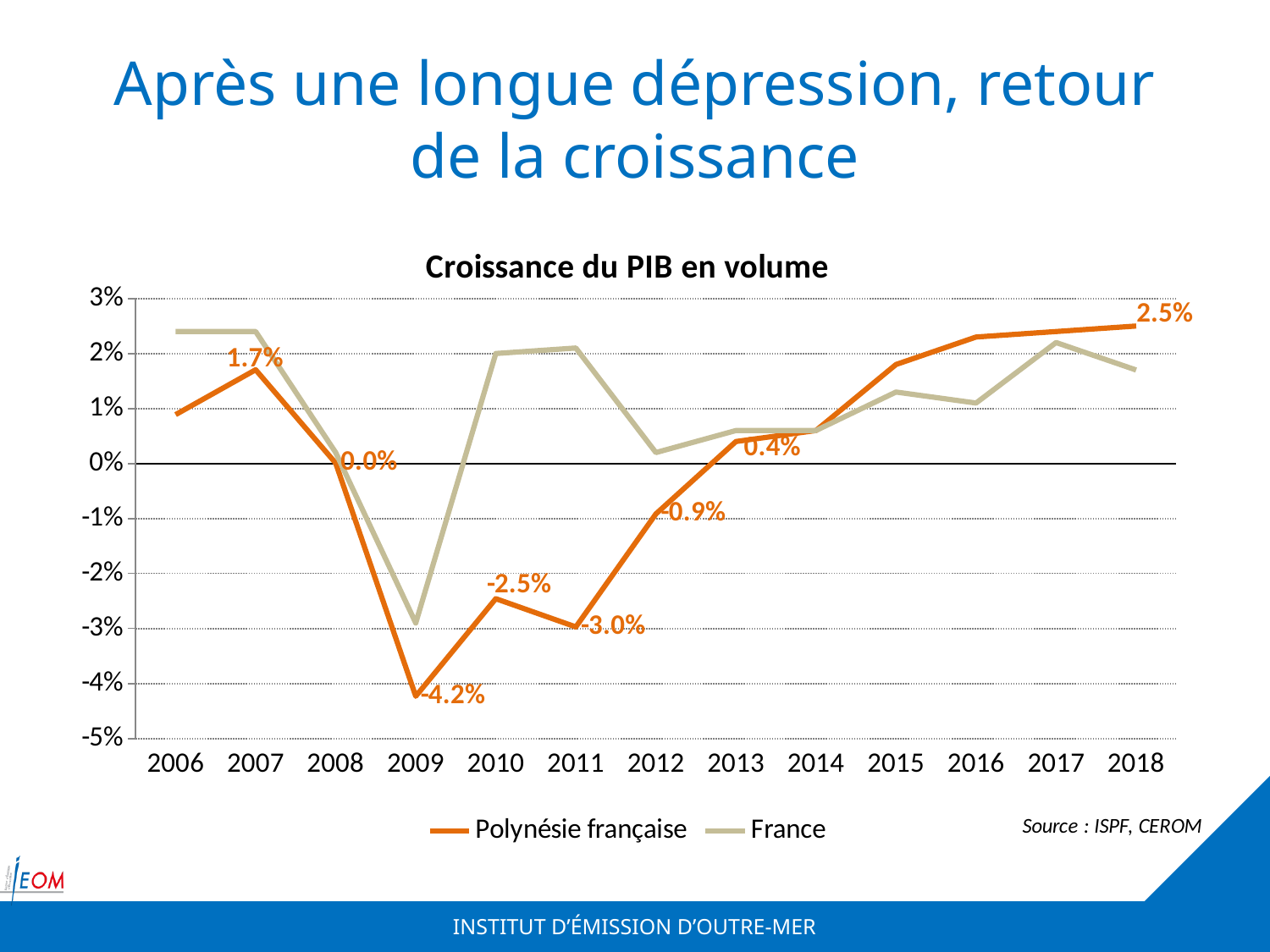
Does the Polynésie française series rise or fall from 2013 to 2018? rise What is the difference between the Polynésie française values for 2018 and 2007? 0.8% What kind of chart is shown on the slide? line chart What is the value for Polynésie française in 2018? 2.5% Is the value for France in 2009 greater or less than -2%? less In which year is the Polynésie française series at its lowest? 2009 How many series does the legend list? 2 What is the title of the chart? Croissance du PIB en volume Which is larger for Polynésie française: the value in 2010 or the value in 2011? 2010 What is the value for Polynésie française in 2011? -3.0% How many years are shown on the x axis? 13 What is the value for Polynésie française in 2009? -4.2%